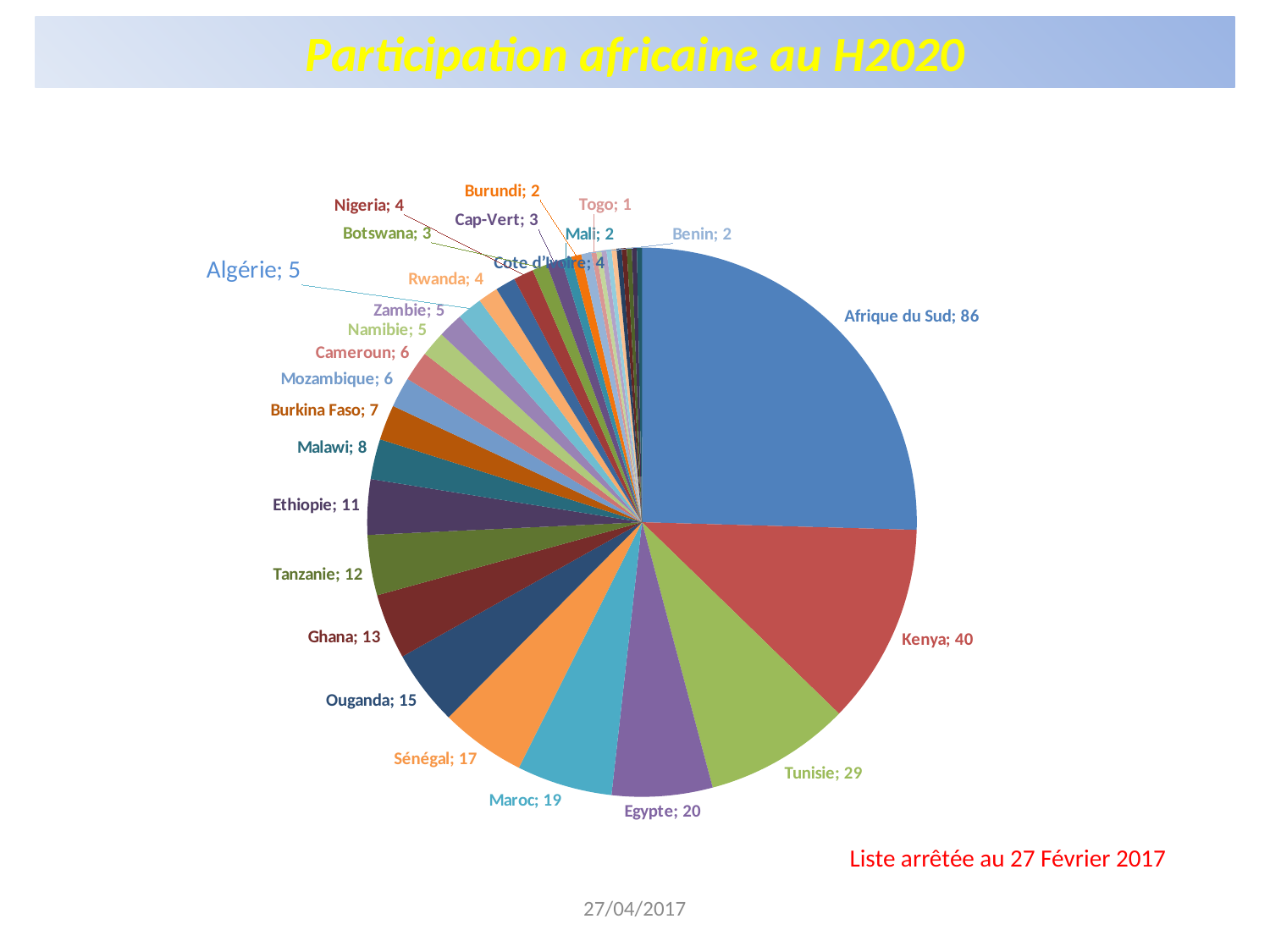
What is the difference between the values for Egypte and Maroc? 1 What is the value for Tunisie? 29 What is the title of the chart? Participation africaine au H2020 What is the value for Sénégal? 17 What is the difference between the values for Afrique du Sud and Kenya? 46 Which is larger, the value for Ghana or the value for Ouganda? Ouganda What is the value for Malawi? 8 What is the value for Afrique du Sud? 86 What is the value for Kenya? 40 Which is larger, the value for Tanzanie or the value for Ethiopie? Tanzanie Which country has the largest slice of the pie? Afrique du Sud What type of chart is shown on the slide? pie chart